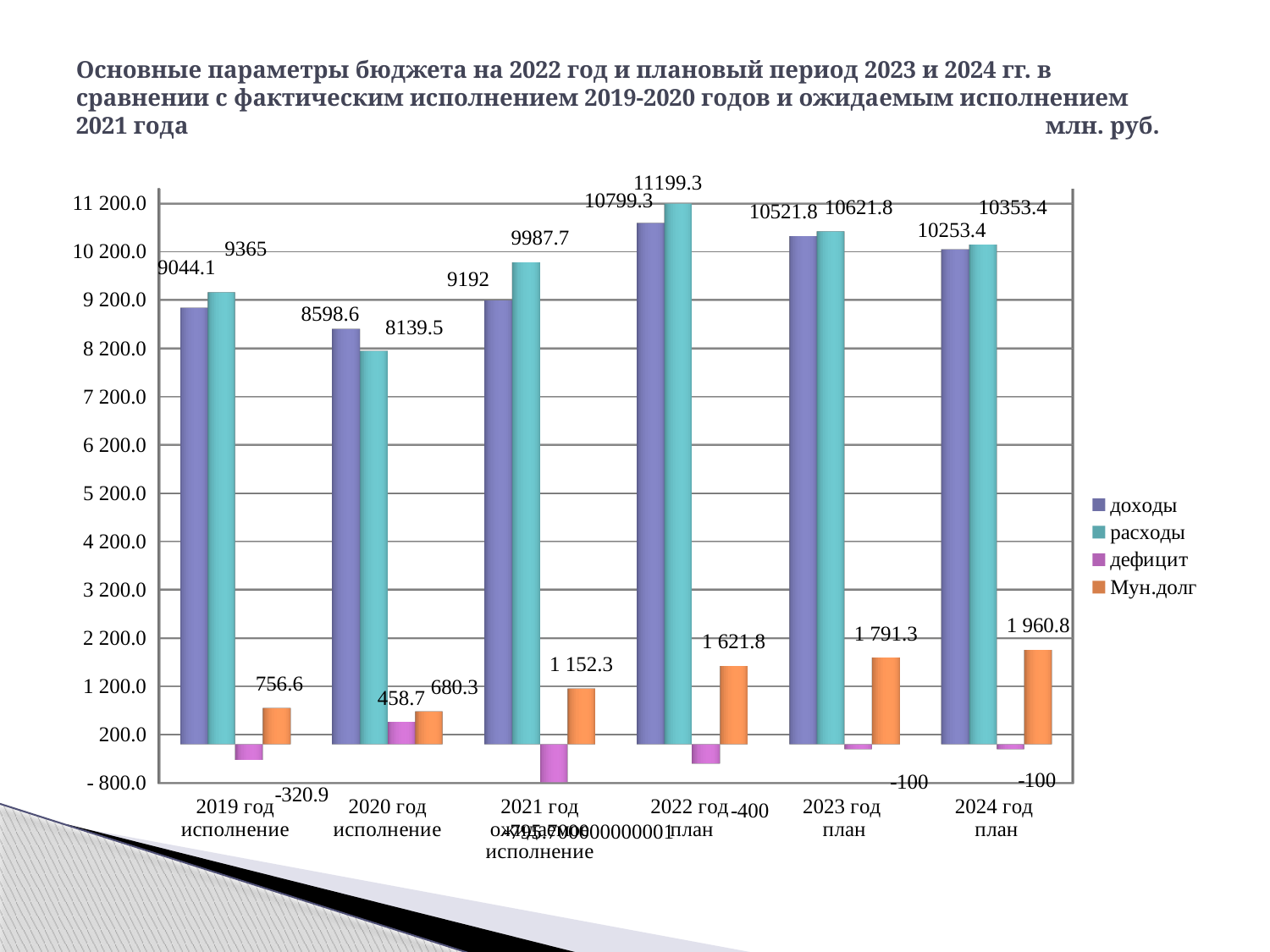
Does the value of Мун.долг rise or fall from 2021 год to 2024 год? rises What kind of chart is shown on the slide? bar chart What is the value of Мун.долг for 2024 год план? 1 960.8 By how much do расходы exceed доходы for 2022 год план? 400 What is the value of дефицит for 2020 год исполнение? 458.7 How many series does the legend list? 4 How many categories are shown on the x axis? 6 Which category has the lowest value of доходы? 2020 год исполнение By how much do расходы exceed доходы for 2023 год план? 100 For 2020 год исполнение, which is larger: доходы or расходы? доходы What is the value of доходы for 2022 год план? 10799.3 Which category has the highest value of расходы? 2022 год план